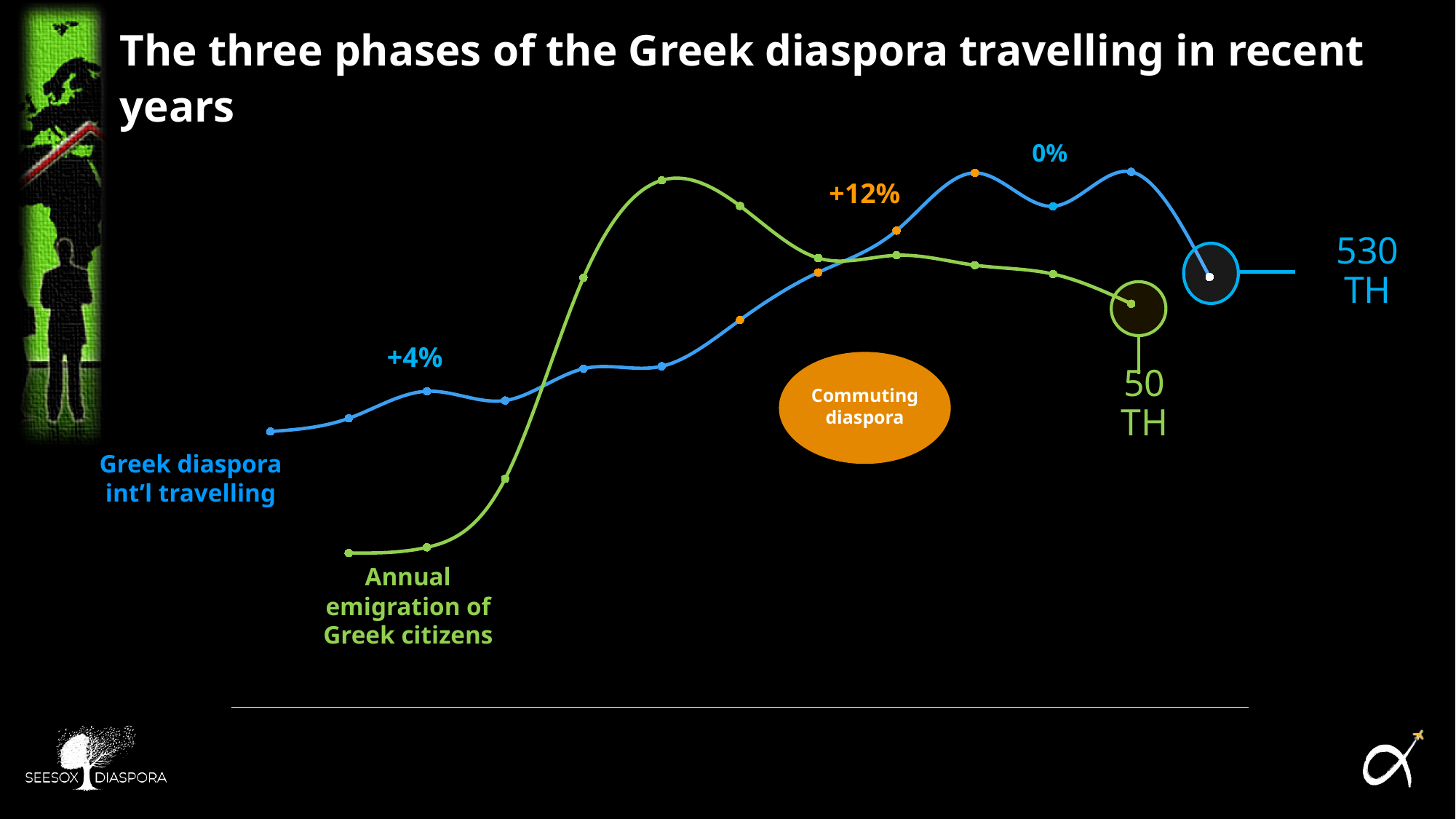
Does the 'Annual emigration of Greek citizens' line rise or fall towards the right end of the chart? fall Which line ends at a higher value: 'Greek diaspora int'l travelling' or 'Annual emigration of Greek citizens'? Greek diaspora int'l travelling What text is written inside the orange oval on the chart? Commuting diaspora What is the final value labelled at the end of the 'Greek diaspora int'l travelling' line? 530 TH What is the final value labelled at the end of the 'Annual emigration of Greek citizens' line? 50 TH What growth rate is labelled on the orange (middle) phase of the 'Greek diaspora int'l travelling' line? +12% Which of the three labelled growth phases has the highest growth rate? +12% How many data series (lines) are plotted on the chart? 2 What is the difference between the two end values labelled on the chart, 530 TH and 50 TH? 480 TH What growth rate is labelled on the first phase of the 'Greek diaspora int'l travelling' line? +4% What growth rate is labelled on the last phase of the 'Greek diaspora int'l travelling' line? 0% What kind of chart is shown on the slide? line chart